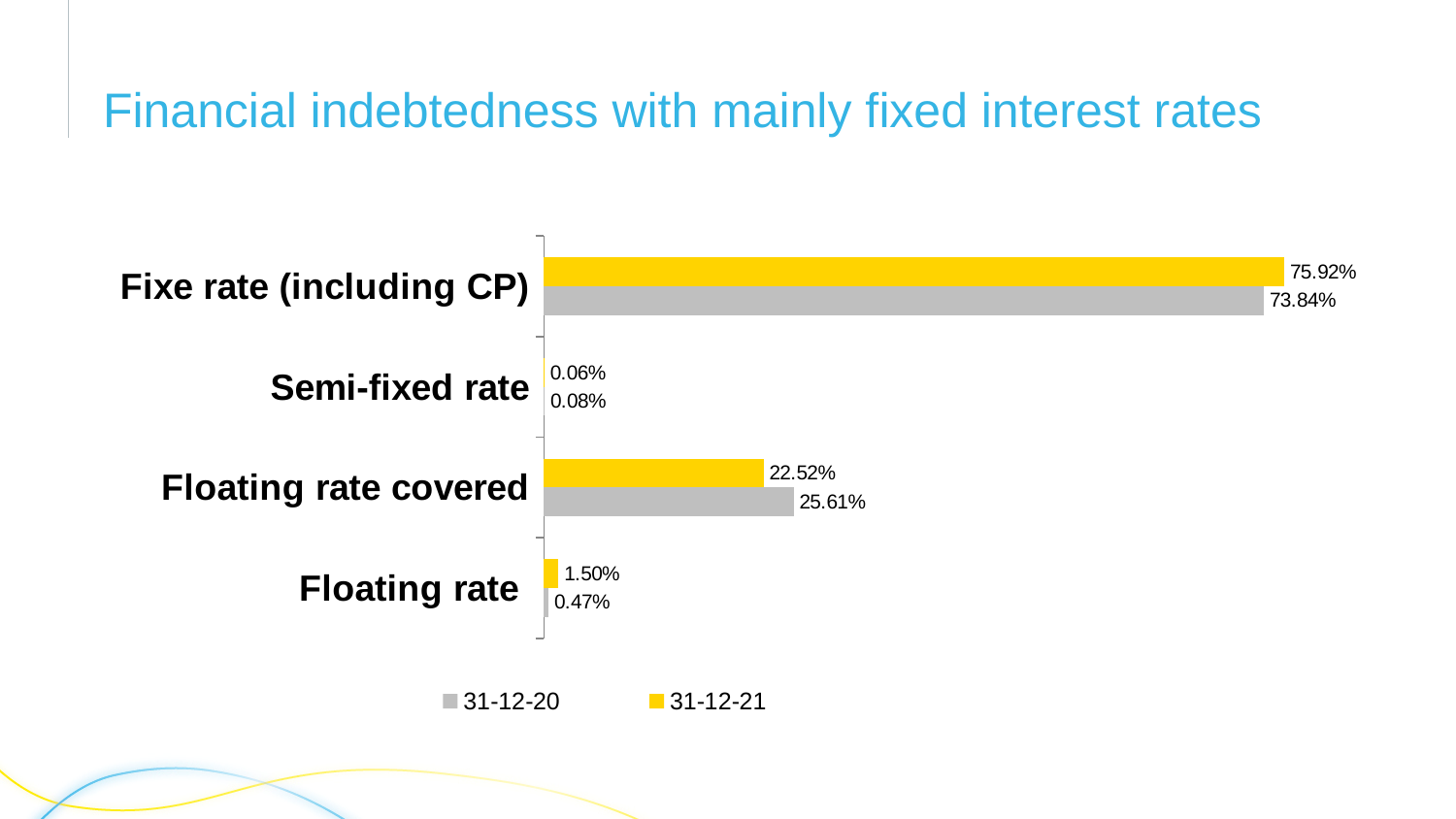
How many categories are shown in the chart? 4 What is the value for Floating rate for 31-12-20? 0.47% Which category has the highest value for 31-12-21? Fixe rate (including CP) What is the difference between the 31-12-20 and 31-12-21 values for Floating rate covered? 3.09 percentage points For Floating rate, which is larger: the 31-12-20 value or the 31-12-21 value? 31-12-21 What is the value for Semi-fixed rate for 31-12-21? 0.06% Which category has the lowest value for 31-12-20? Semi-fixed rate How many series does the legend list? 2 What is the value for Fixe rate (including CP) for 31-12-21? 75.92% What is the difference between the 31-12-21 and 31-12-20 values for Fixe rate (including CP)? 2.08 percentage points What kind of chart is shown on the slide? Bar chart What is the value for Floating rate covered for 31-12-20? 25.61%